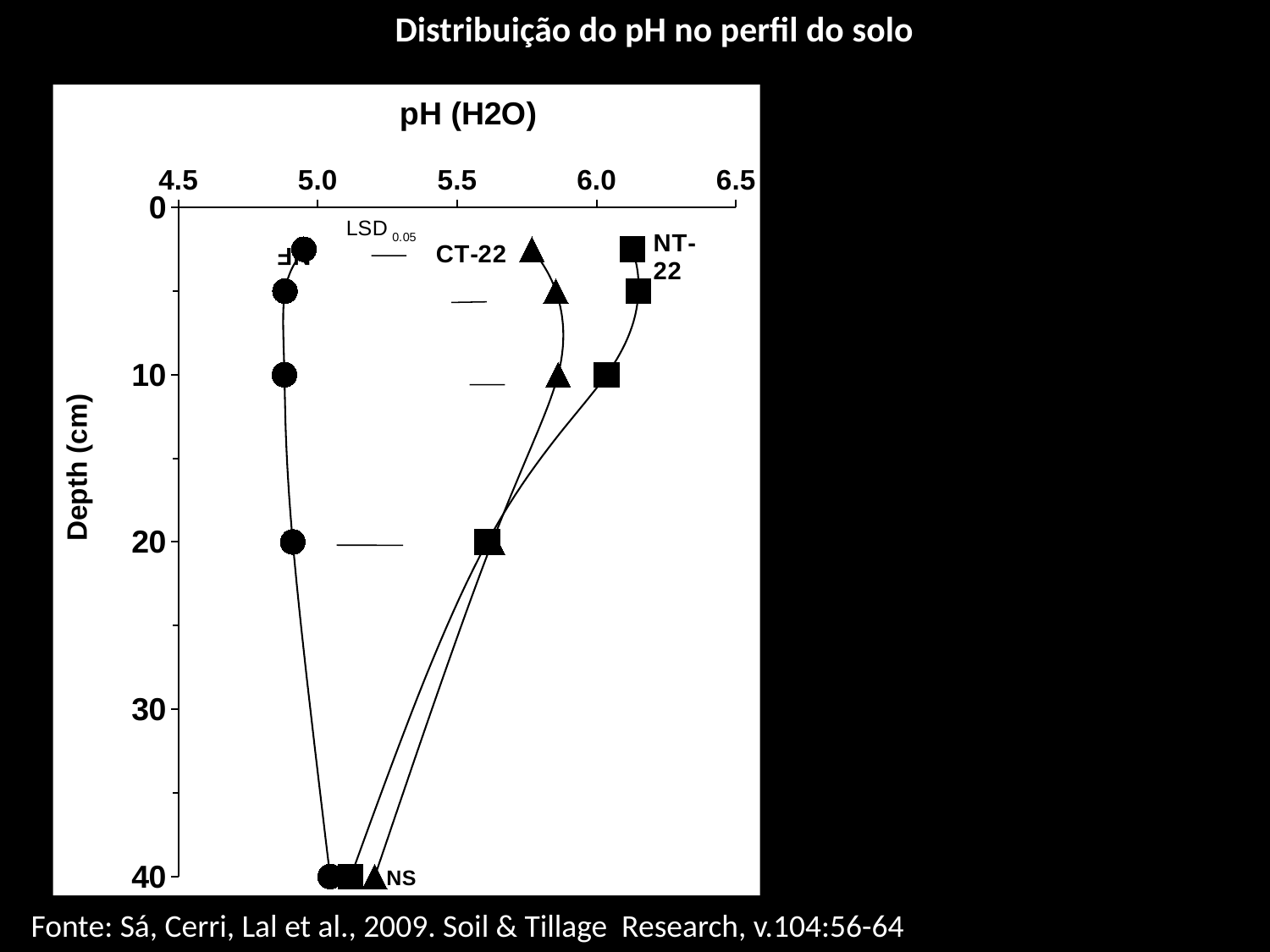
Is the pH value for CT-22 at a depth of 10 cm greater or less than 5.5? greater What is the title of the chart on the slide? Distribuição do pH no perfil do solo What is the label of the horizontal axis of the chart? pH (H2O) Does the pH of the NT-22 series rise or fall as depth increases from 5 cm to 40 cm? fall Is the pH value for CT-22 at a depth of 40 cm greater or less than 5.0? greater At a depth of 20 cm, which series has the lowest pH? the series with circle markers What kind of chart is shown on the slide? line chart At a depth of 5 cm, which series has the highest pH? NT-22 How many depth points are plotted for the NT-22 series? 5 Is the pH value for NT-22 at a depth of 10 cm greater or less than 5.5? greater At a depth of 10 cm, which series has the higher pH, NT-22 or CT-22? NT-22